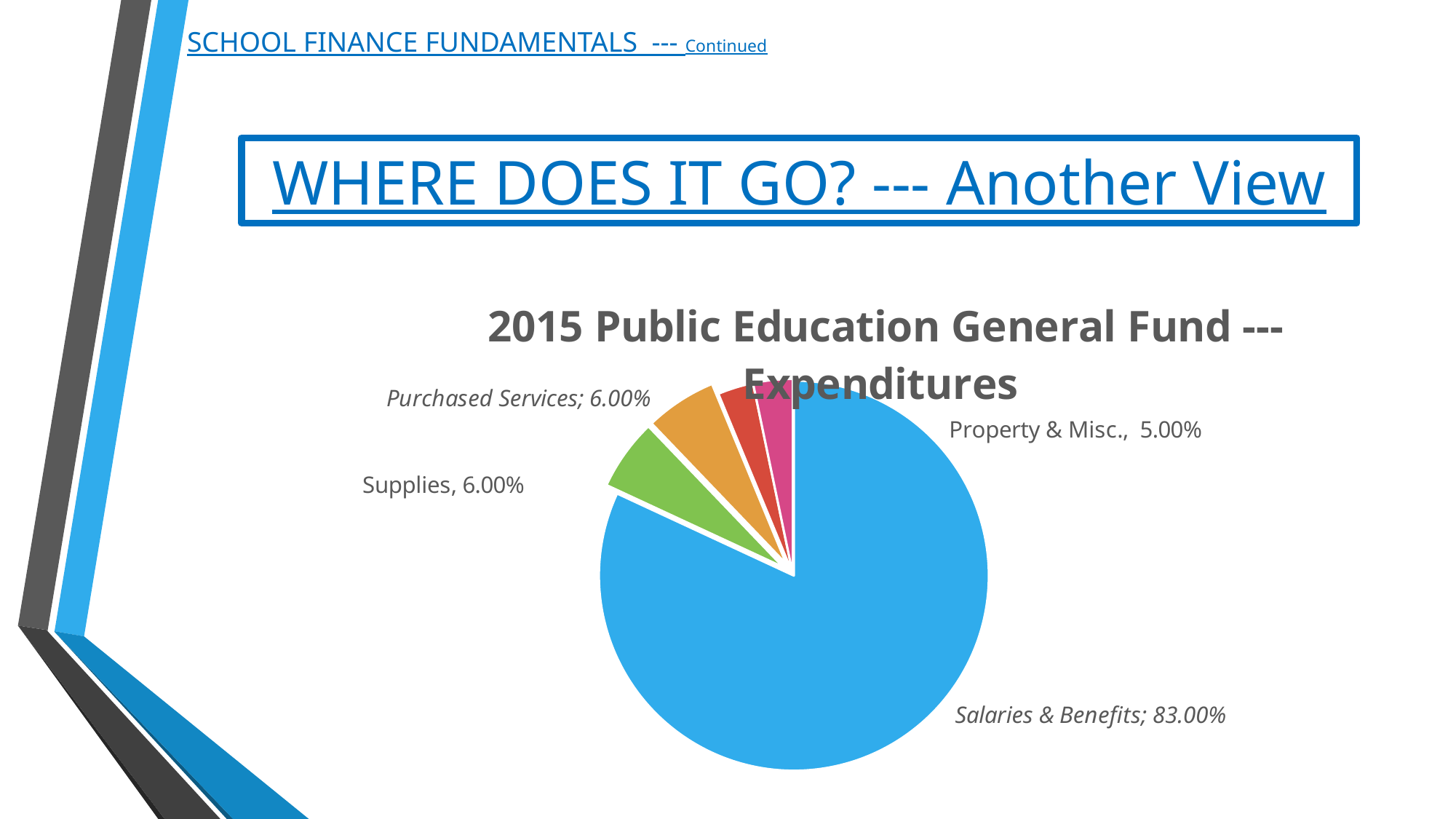
What is the difference in percentage points between Purchased Services and Property & Misc.? 1.00% What percentage of expenditures is shown for Supplies? 6.00% What is the difference in percentage points between Salaries & Benefits and Supplies? 77.00% What percentage of the 2015 Public Education General Fund expenditures goes to Salaries & Benefits? 83.00% What percentage of expenditures is shown for Purchased Services? 6.00% Which is larger, the share for Salaries & Benefits or the share for Supplies? Salaries & Benefits Which is larger, the share for Purchased Services or the share for Property & Misc.? Purchased Services What is the title of the chart on the slide? 2015 Public Education General Fund --- Expenditures What percentage of expenditures is shown for Property & Misc.? 5.00% What colour is the Salaries & Benefits slice of the pie chart? Blue Which category accounts for the largest share of the pie chart? Salaries & Benefits What type of chart is shown on the slide? Pie chart